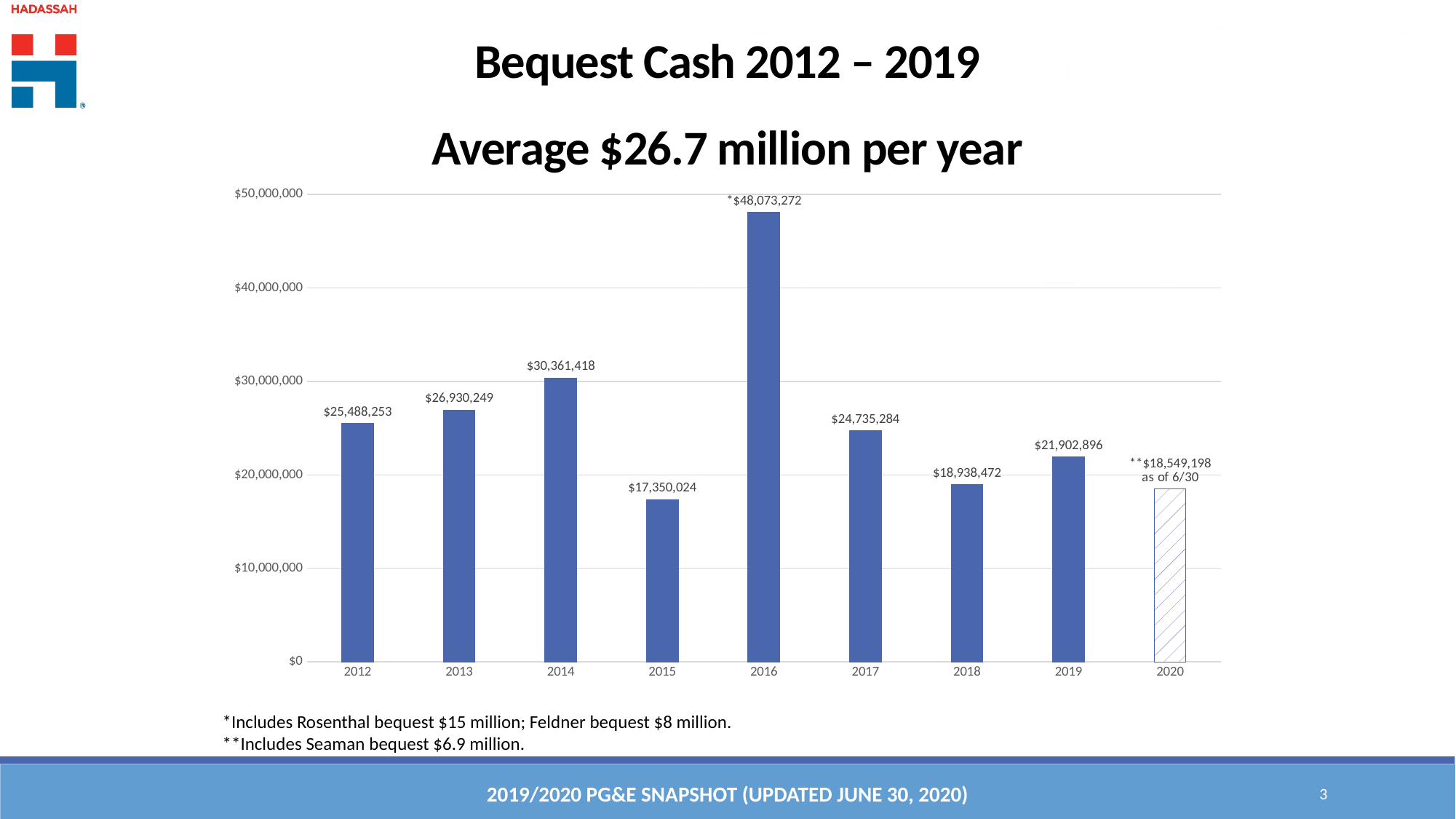
Do the bequest cash values rise or fall from 2012 to 2014? rise Is the value for 2017 greater or less than $30,000,000? less What is the bequest cash value for 2018? $18,938,472 Which year has the highest bequest cash value? 2016 What is the bequest cash value for 2014? $30,361,418 What kind of chart is shown on the slide? bar chart What is the difference between the 2014 and 2013 bequest cash values? $3,431,169 What is the bequest cash value shown for 2020 as of 6/30? $18,549,198 What is the difference between the 2019 and 2018 bequest cash values? $2,964,424 Which year has a larger bequest cash value, 2012 or 2017? 2012 Which year has the lowest bequest cash value? 2015 How many years are shown on the x axis of the chart? 9